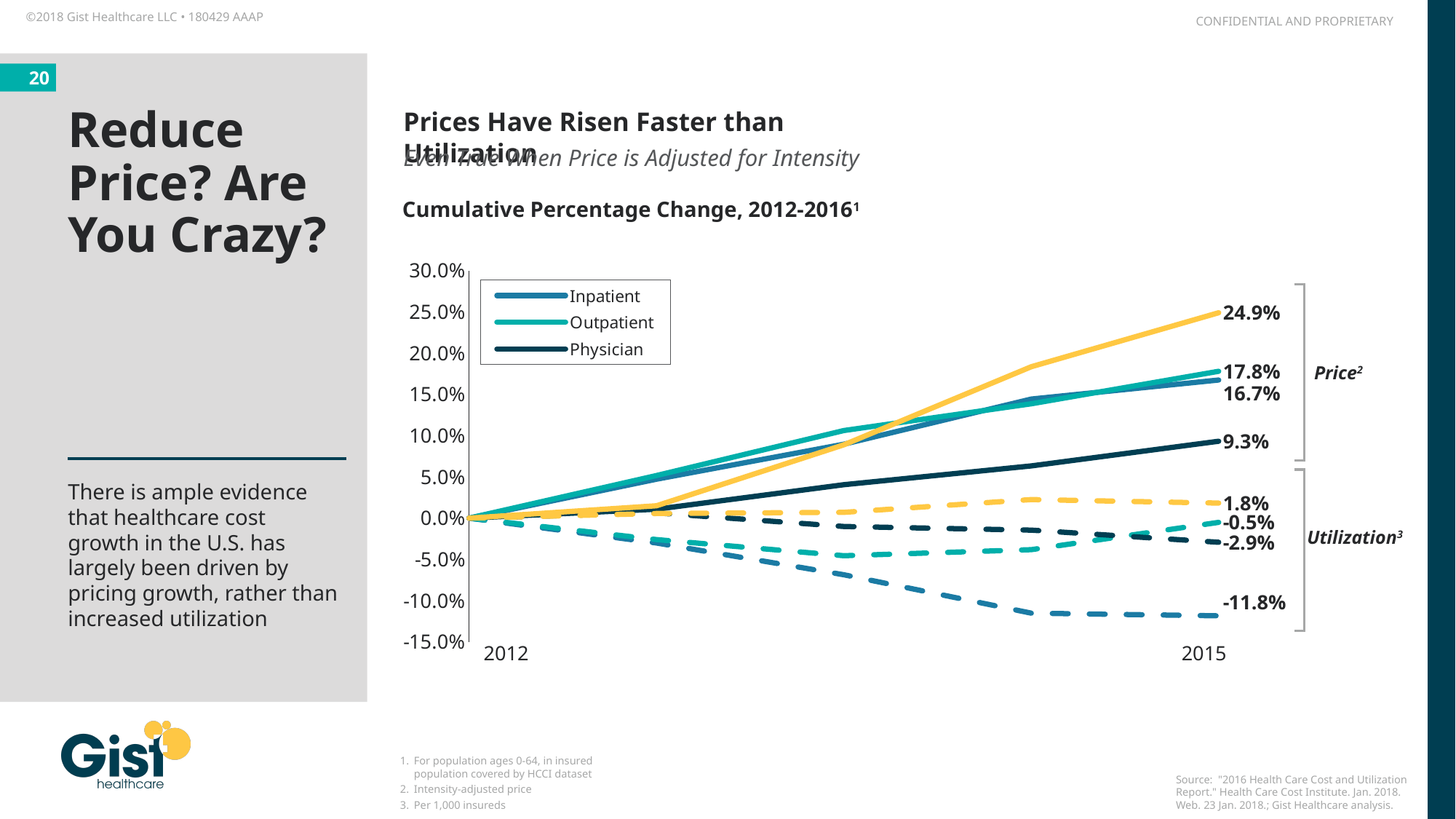
What is the cumulative percentage change in Physician price by the end of the period? 9.3% Does the Physician price line rise or fall from 2012 to 2015? rises What is the cumulative percentage change in Inpatient utilization by the end of the period? -11.8% What is the highest cumulative percentage change labeled at the end of any line? 24.9% What kind of chart is shown on the slide? line chart How many data labels are printed at the right end of the lines? 8 What is the lowest cumulative percentage change labeled at the end of any line? -11.8% How many series does the chart's legend list? 3 Which is larger at the end of the period: the Outpatient price change or the Inpatient price change? Outpatient price change What is the cumulative percentage change in Outpatient price by the end of the period? 17.8% What is the difference in percentage points between the Physician price change (9.3%) and the Physician utilization change (-2.9%)? 12.2 percentage points What is the title printed above the chart? Cumulative Percentage Change, 2012-2016